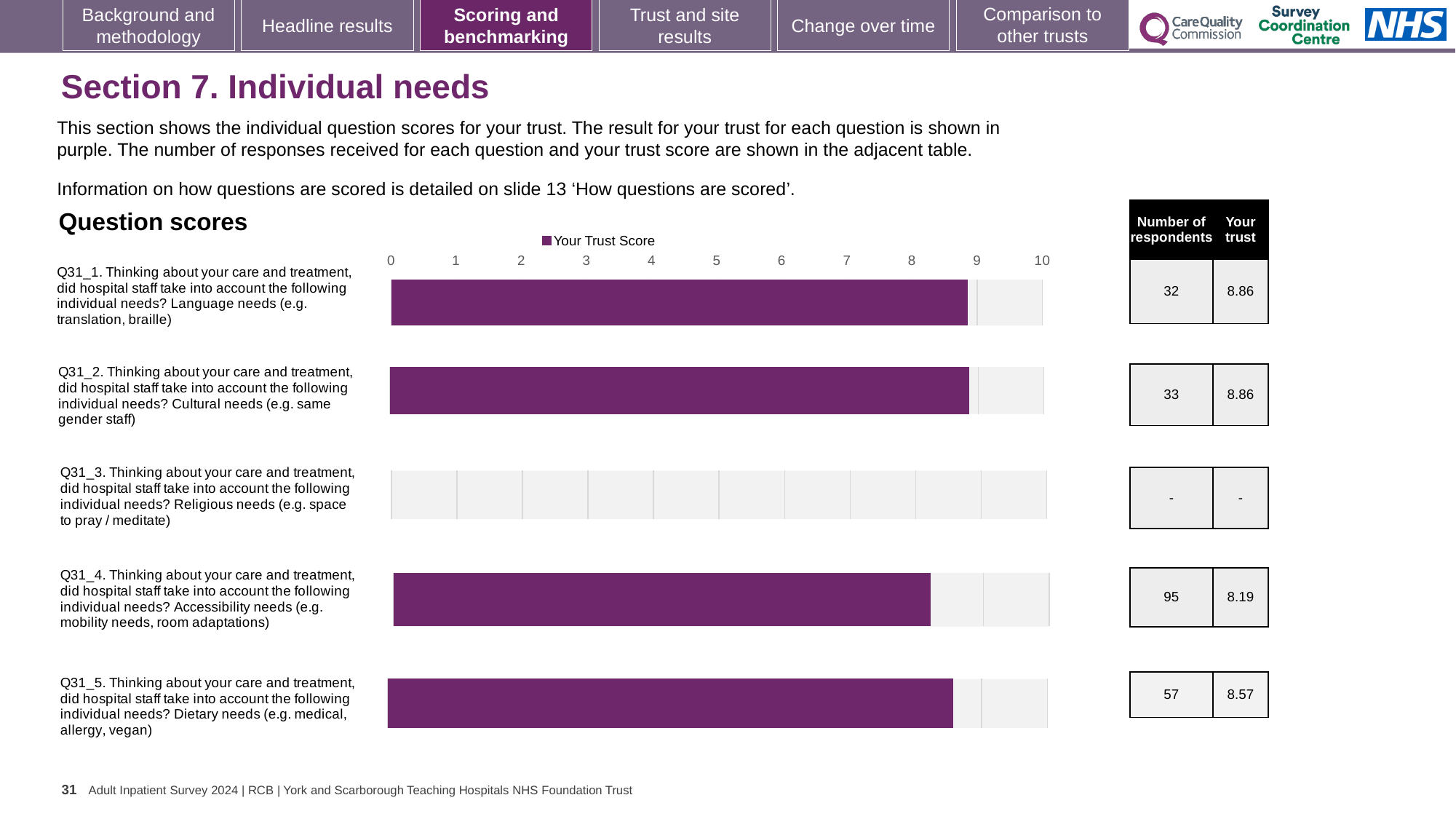
What is the trust score for Q31_5 (Dietary needs)? 8.57 What is the trust score for Q31_4 (Accessibility needs)? 8.19 How many questions are listed in the Question scores chart? 5 What is the difference between the trust scores for Q31_5 (Dietary needs) and Q31_4 (Accessibility needs)? 0.38 Which has the larger trust score, Q31_5 (Dietary needs) or Q31_4 (Accessibility needs)? Q31_5 (Dietary needs) Is the trust score for Q31_2 (Cultural needs) greater or less than 8? greater How many respondents answered Q31_4 (Accessibility needs)? 95 Which question with a plotted bar has the lowest trust score? Q31_4 (Accessibility needs) Which question has no trust score shown in the chart? Q31_3 (Religious needs) What kind of chart is used to show the question scores? bar chart What is the trust score for Q31_1 (Language needs)? 8.86 How many series does the chart legend list? 1